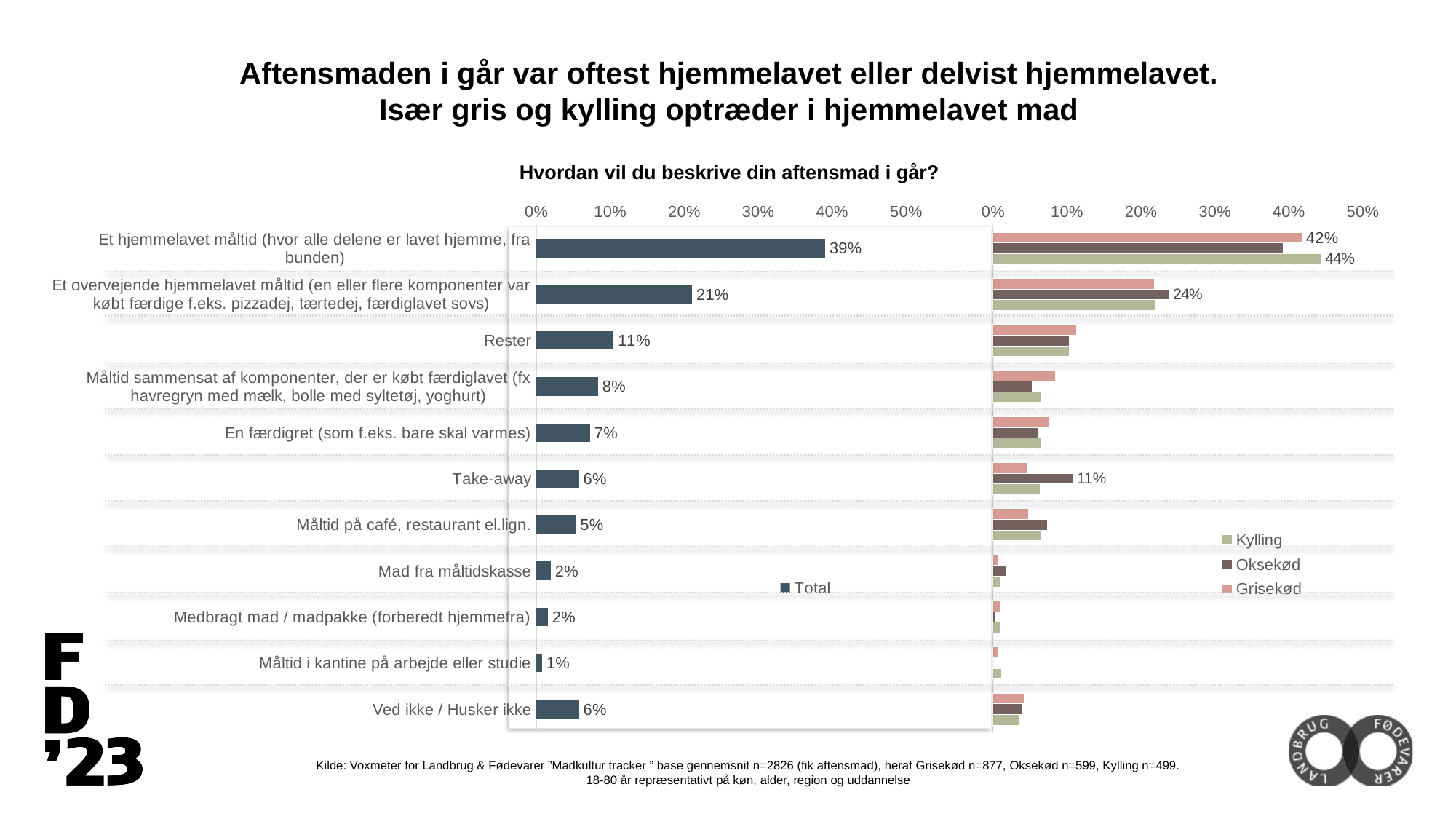
In the left chart (Total), what is the value for "Rester"? 11% In the right chart, is the Oksekød value for "Et hjemmelavet måltid" greater or less than 30%? greater In the left chart (Total), which category has the lowest value? Måltid i kantine på arbejde eller studie In the right chart, what is the Oksekød value for "Et overvejende hjemmelavet måltid"? 24% In the left chart (Total), which category has the highest value? Et hjemmelavet måltid (hvor alle delene er lavet hjemme, fra bunden) In the right chart, what is the Kylling value for "Et hjemmelavet måltid (hvor alle delene er lavet hjemme, fra bunden)"? 44% In the left chart (Total), what is the difference between "Et hjemmelavet måltid" and "Et overvejende hjemmelavet måltid"? 18% In the right chart, what is the Oksekød value for "Take-away"? 11% In the right chart, what is the Grisekød value for "Et hjemmelavet måltid (hvor alle delene er lavet hjemme, fra bunden)"? 42% How many series does the legend of the right chart list? 3 What kind of chart is the left chart (Total)? Bar chart In the left chart (Total), what is the value for "Et hjemmelavet måltid (hvor alle delene er lavet hjemme, fra bunden)"? 39%